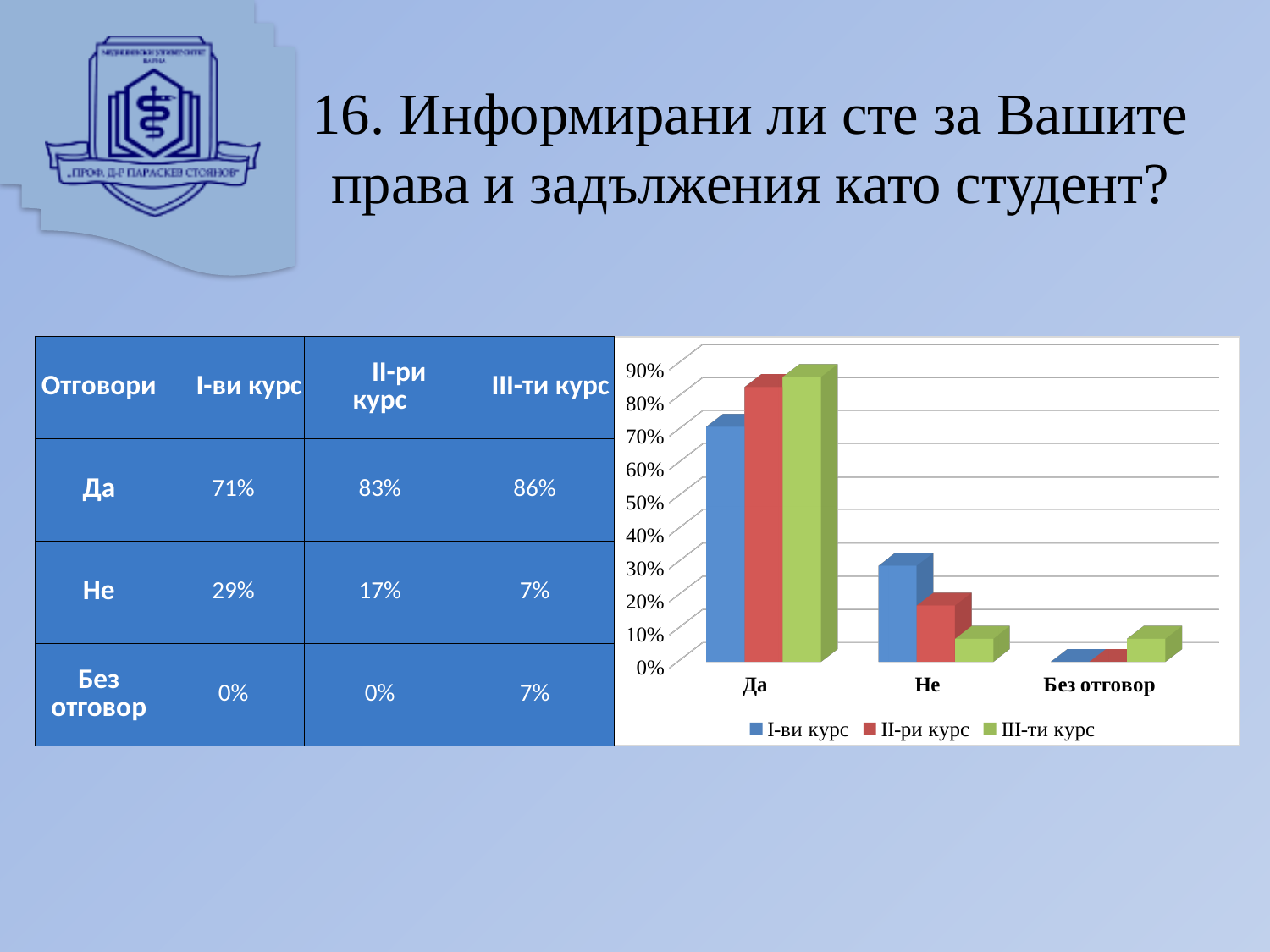
What is the difference between the II-ри курс and I-ви курс values in the Да category? 12% What is the value for III-ти курс in the Не category? 7% Which is larger: the I-ви курс value for Не or the II-ри курс value for Не? I-ви курс Which series has the highest value in the Да category? III-ти курс What is the value for I-ви курс in the Да category? 71% Which series has the lowest value in the Не category? III-ти курс Is the value for II-ри курс in the Да category greater or less than 80%? greater How many series does the chart legend list? 3 Which series is shown in green in the chart? III-ти курс What is the value for II-ри курс in the Без отговор category? 0% How many categories are shown on the x axis of the chart? 3 What kind of chart is shown on the slide? bar chart